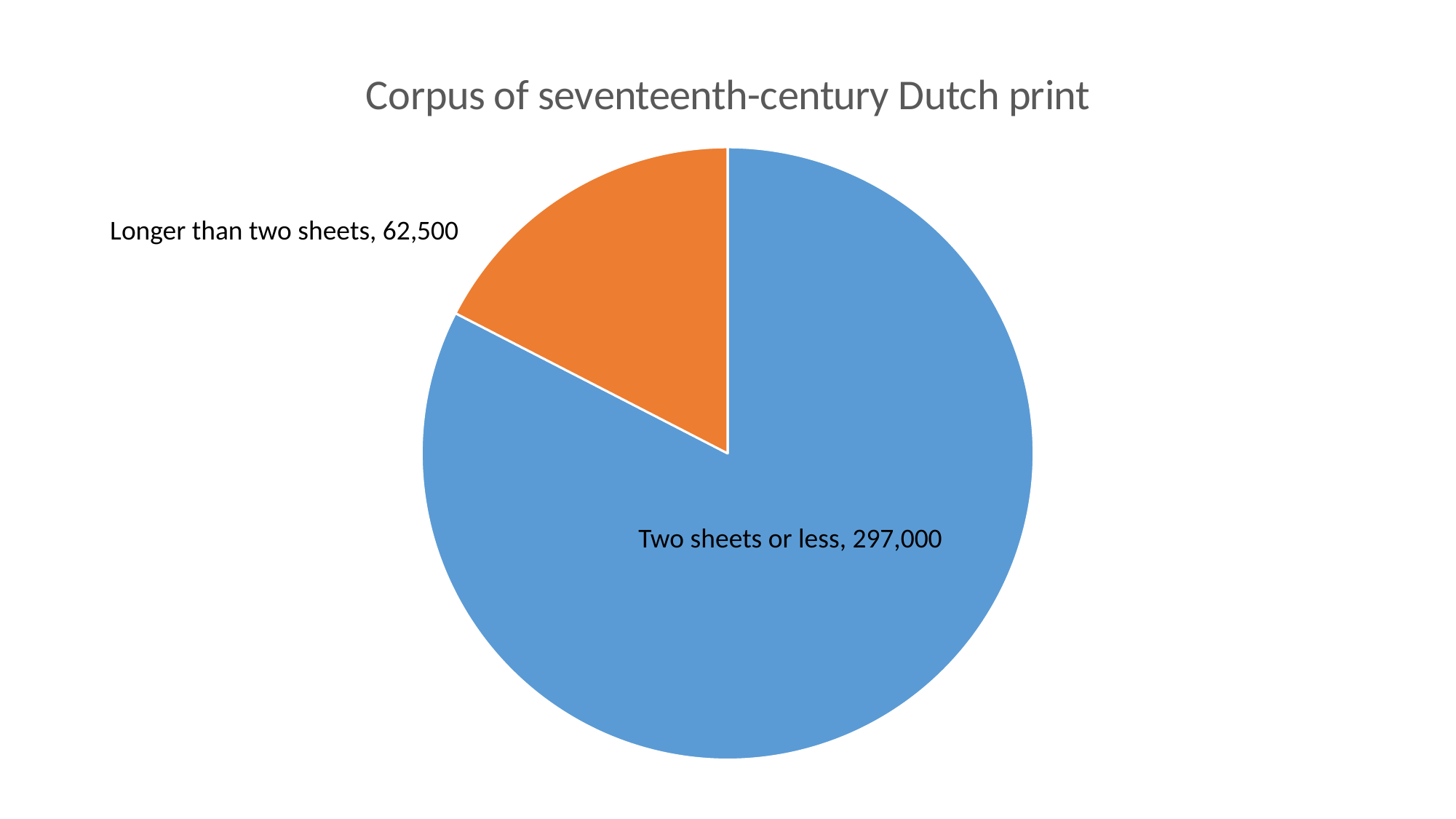
Which category has the smallest slice of the pie? Longer than two sheets What is the total of the two slices in the pie chart? 359,500 What is the title of the chart? Corpus of seventeenth-century Dutch print What is the value for "Longer than two sheets"? 62,500 Which category has the largest slice of the pie? Two sheets or less Which is larger, the value for "Two sheets or less" or the value for "Longer than two sheets"? Two sheets or less What is the value for "Two sheets or less"? 297,000 What is the difference between the values for "Two sheets or less" and "Longer than two sheets"? 234,500 What colour is the slice for "Longer than two sheets"? orange What kind of chart is shown on the slide? pie chart What share of the pie does "Longer than two sheets" represent, to one decimal place? 17.4% How many slices does the pie chart have? 2